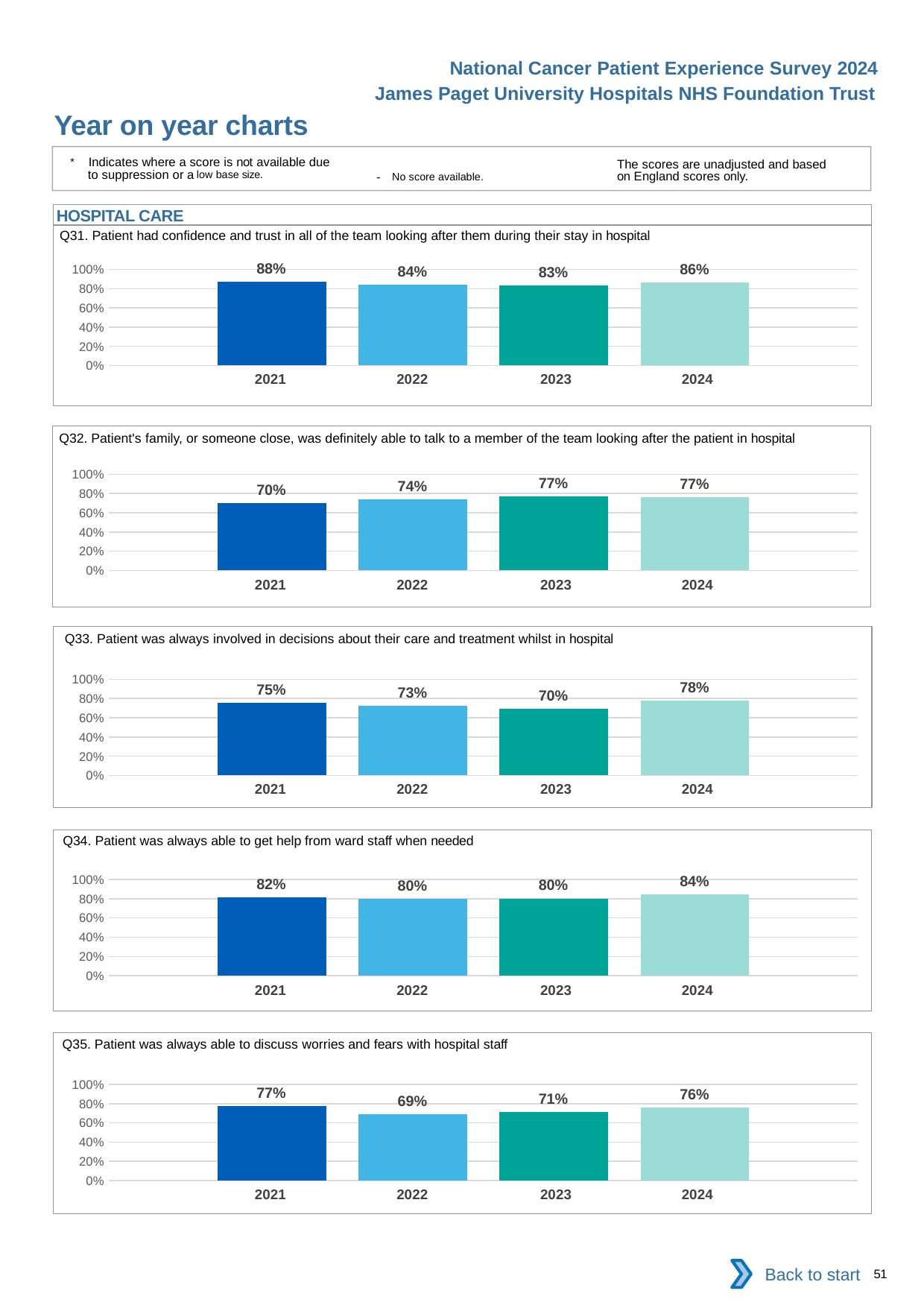
In the Q35 chart, what is the value for 2022? 69% In the Q31 chart, what is the value for 2021? 88% In the Q32 chart, do the values rise or fall from 2021 to 2023? Rise How many charts are shown on the slide? 5 How many years are shown in the Q31 chart? 4 In the Q32 chart, which year has the lowest value? 2021 In the Q34 chart, what is the difference between the 2024 value and the 2022 value? 4% In the Q35 chart, which is larger, the value for 2021 or the value for 2023? 2021 In the Q33 chart, what is the value for 2023? 70% In the Q33 chart, which year has the highest value? 2024 In the Q31 chart, what is the difference between the 2021 value and the 2023 value? 5% What kind of chart is the Q33 chart? Bar chart